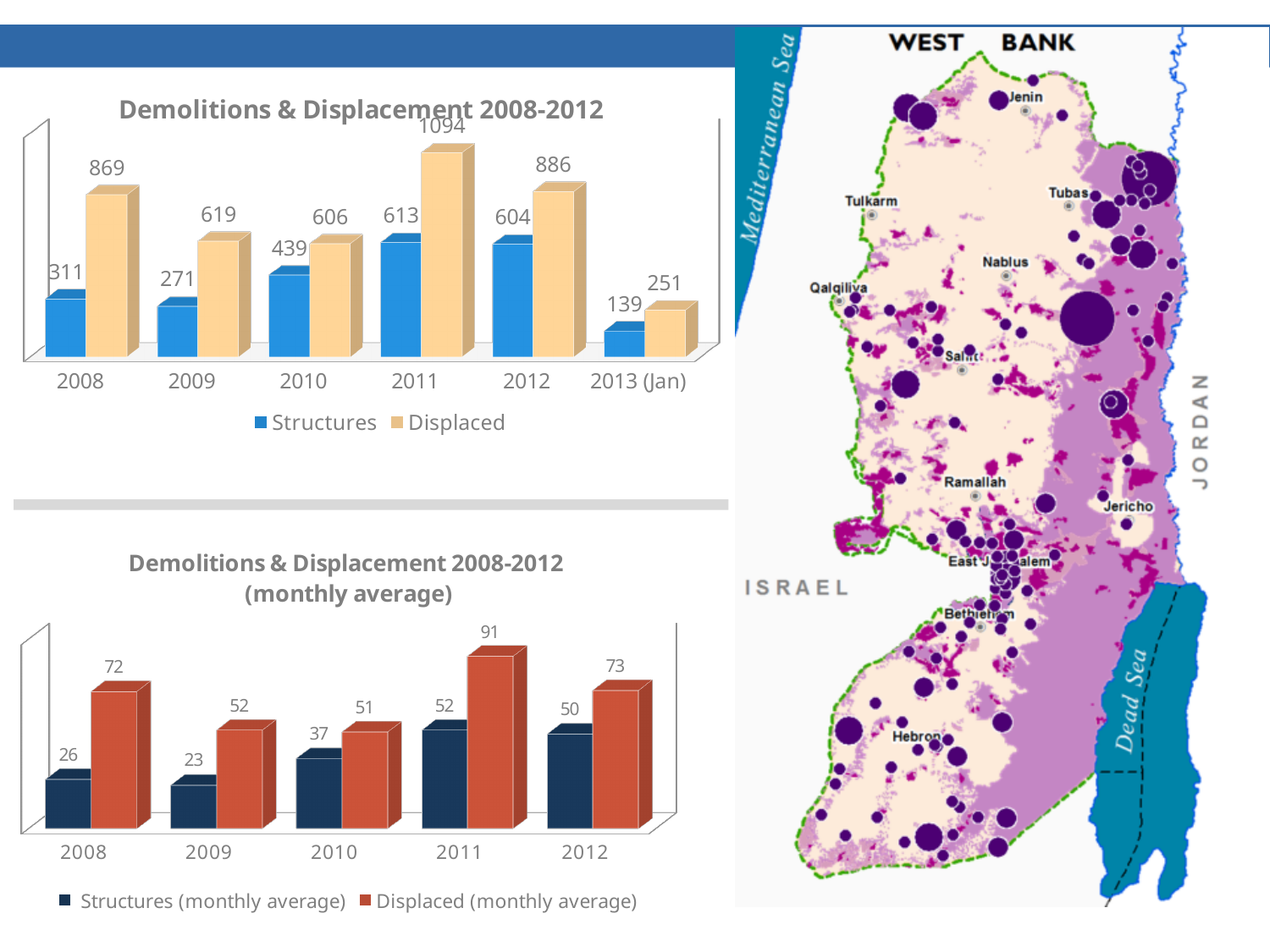
In the top chart 'Demolitions & Displacement 2008-2012', how many series does the legend list? 2 In the top chart 'Demolitions & Displacement 2008-2012', what is the Structures value for 2013 (Jan)? 139 In the bottom chart 'Demolitions & Displacement 2008-2012 (monthly average)', what is the difference between the Displaced (monthly average) and Structures (monthly average) values for 2008? 46 In the bottom chart 'Demolitions & Displacement 2008-2012 (monthly average)', what is the Displaced (monthly average) value for 2011? 91 What kind of chart is the bottom chart 'Demolitions & Displacement 2008-2012 (monthly average)'? bar chart In the top chart 'Demolitions & Displacement 2008-2012', how many categories are shown on the x axis? 6 In the top chart 'Demolitions & Displacement 2008-2012', what is the Displaced value for 2011? 1094 In the top chart 'Demolitions & Displacement 2008-2012', what is the difference between the Displaced values for 2011 and 2012? 208 In the top chart 'Demolitions & Displacement 2008-2012', which year has the highest Displaced value? 2011 In the bottom chart 'Demolitions & Displacement 2008-2012 (monthly average)', which year has the lowest Structures (monthly average) value? 2009 In the top chart 'Demolitions & Displacement 2008-2012', which category has the lowest Structures value? 2013 (Jan) In the bottom chart 'Demolitions & Displacement 2008-2012 (monthly average)', is the Structures (monthly average) value for 2010 larger or smaller than the Displaced (monthly average) value for 2010? smaller